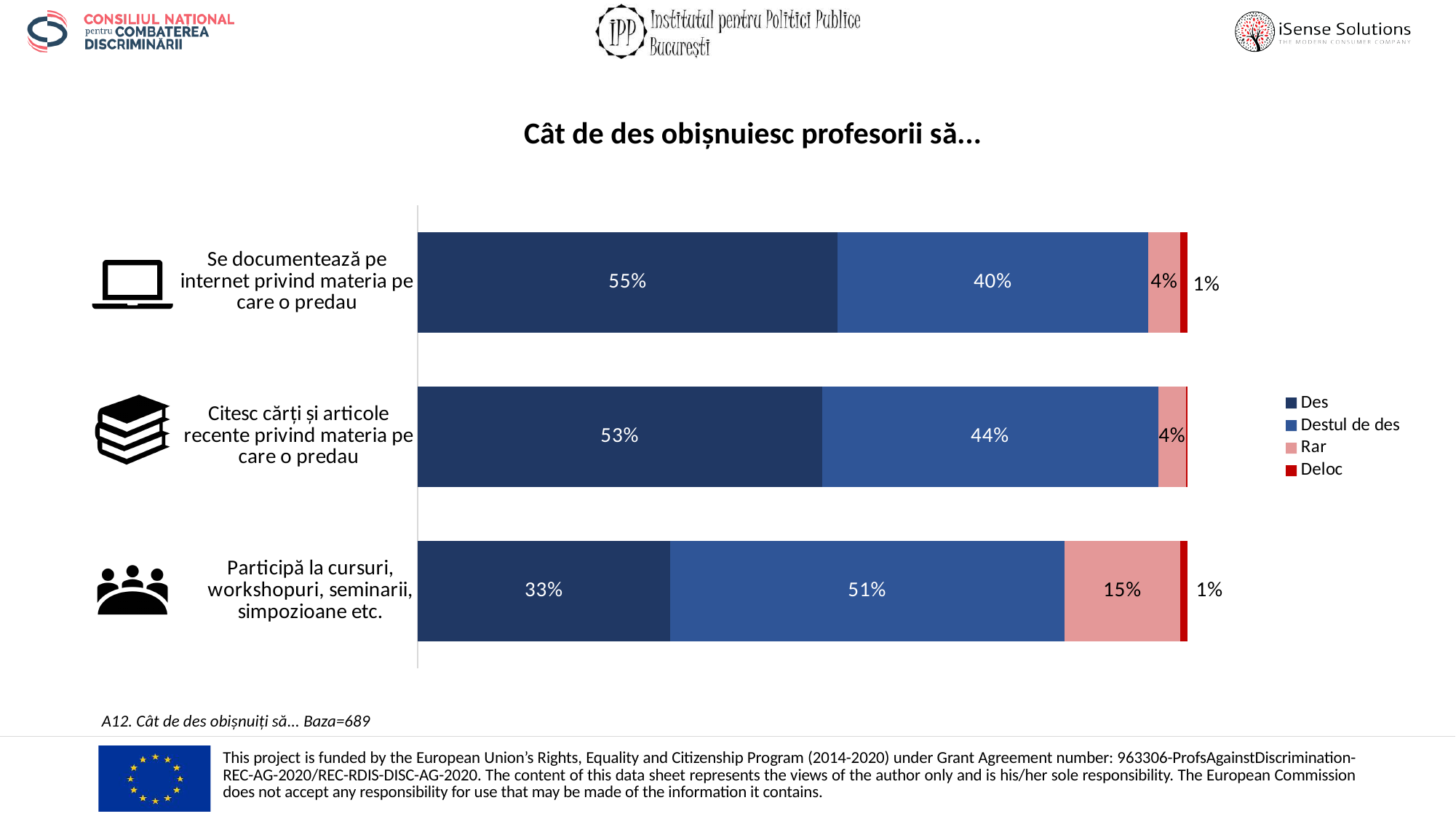
How many series does the legend list? 4 What is the 'Destul de des' value for 'Citesc cărți și articole recente privind materia pe care o predau'? 44% What is the 'Deloc' value for 'Participă la cursuri, workshopuri, seminarii, simpozioane etc.'? 1% What kind of chart is shown on the slide? stacked bar chart Which is larger: the 'Destul de des' value for 'Participă la cursuri' or for 'Se documentează pe internet'? Participă la cursuri Which category has the highest 'Des' value? Se documentează pe internet privind materia pe care o predau What is the title of the chart? Cât de des obișnuiesc profesorii să... How many categories are plotted in the chart? 3 Which category has the lowest 'Des' value? Participă la cursuri, workshopuri, seminarii, simpozioane etc. What is the difference between the 'Des' values for 'Se documentează pe internet' and 'Participă la cursuri, workshopuri, seminarii, simpozioane etc.'? 22% What is the 'Rar' value for 'Participă la cursuri, workshopuri, seminarii, simpozioane etc.'? 15% What is the 'Des' value for 'Se documentează pe internet privind materia pe care o predau'? 55%